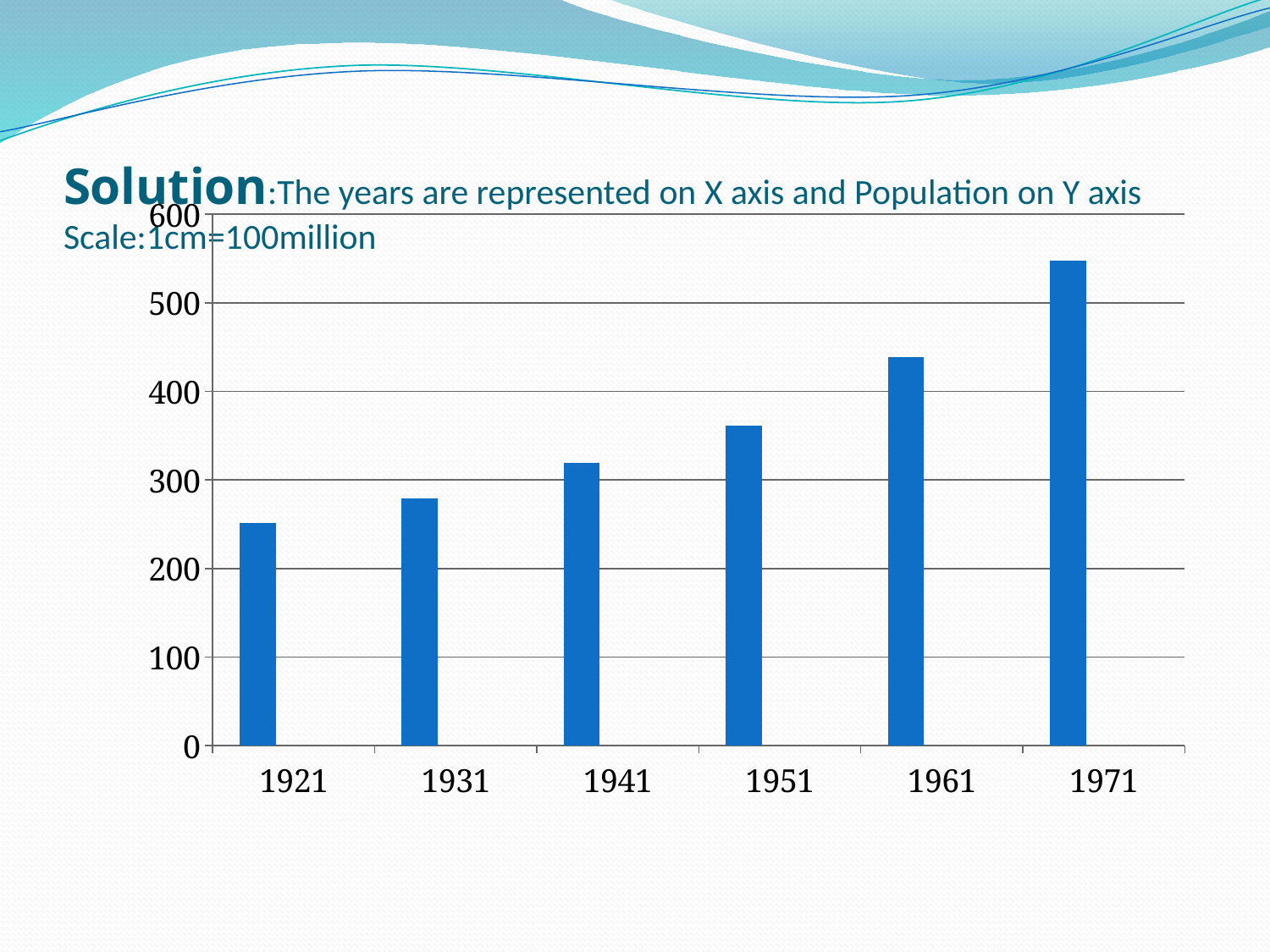
Is the value for 1921 greater or less than 300? less Which year has the highest bar in the chart? 1971 What kind of chart is shown on the slide? bar chart How many years are shown on the x axis of the chart? 6 Do the values rise or fall from 1921 to 1971 along the x axis? rise What is the highest value shown on the y axis of the chart? 600 Is the value for 1961 greater or less than 400? greater Is the value for 1951 greater or less than 400? less Which year has the lowest bar in the chart? 1921 Which is larger, the value for 1961 or the value for 1951? 1961